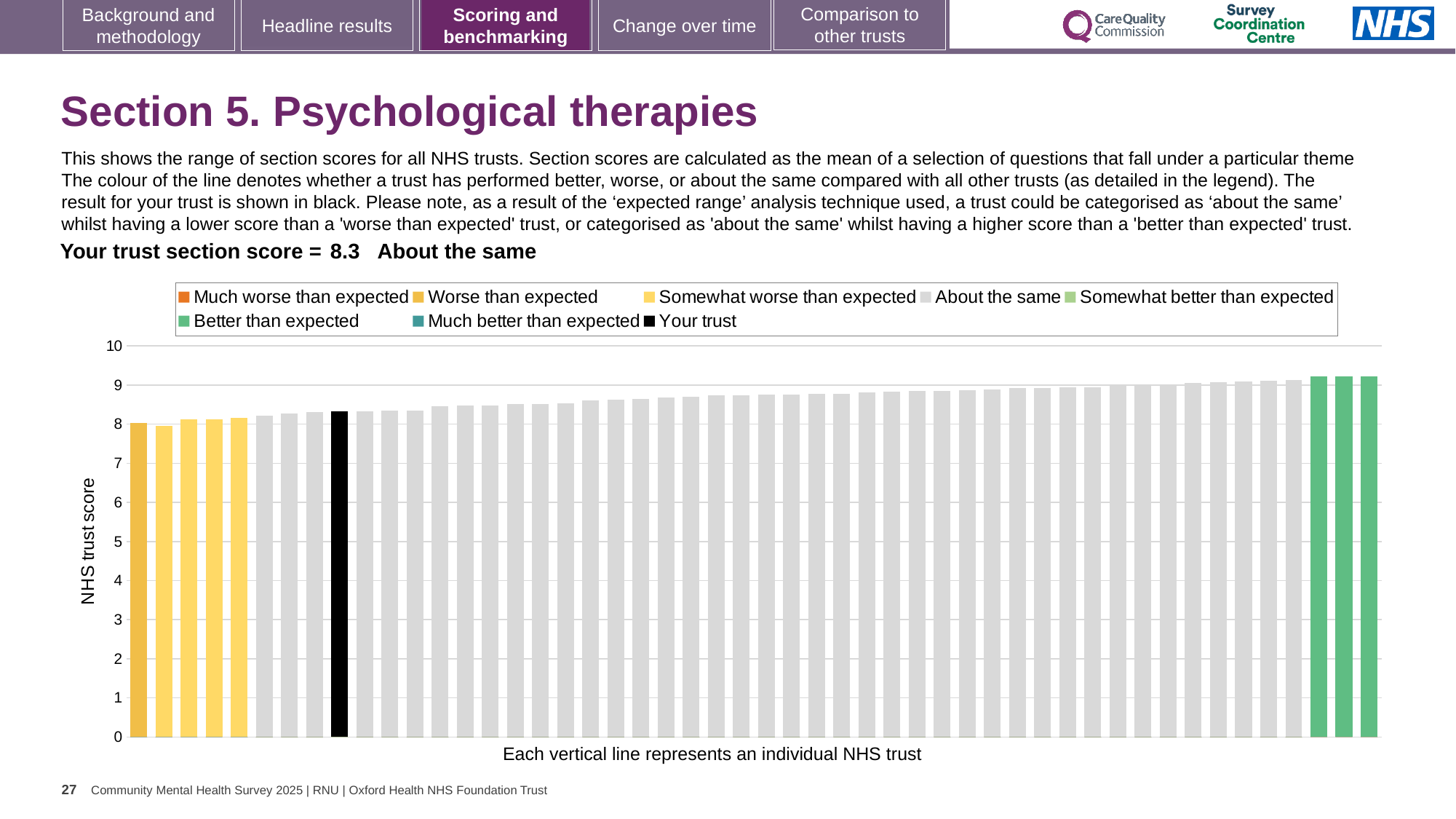
How many entries does the chart legend list? 8 Do the bar values rise or fall from left to right across the chart? Rise Is the value of the rightmost bar greater or less than 9? greater Which category is your trust placed in for this section? About the same Which is higher: the black 'Your trust' bar or the leftmost bar? Your trust Is the value of the black 'Your trust' bar greater or less than 8? greater What is the label on the vertical axis of the chart? NHS trust score Is the value of the leftmost bar greater or less than 9? less What kind of chart is shown on the slide? Bar chart What is the section score for your trust shown on the slide? 8.3 How many green 'Better than expected' bars are shown on the chart? 3